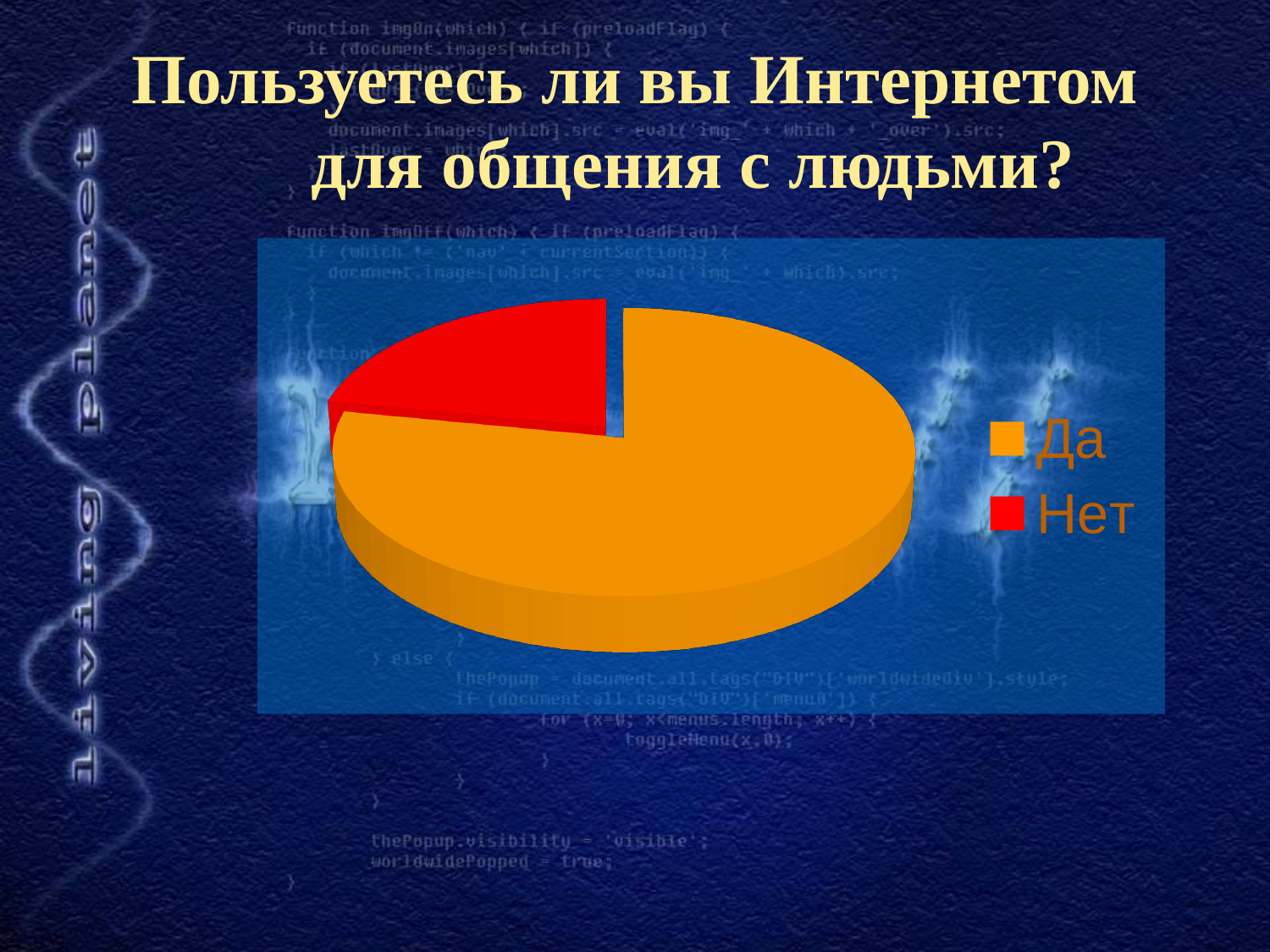
Which slice is larger, Да or Нет? Да Which category has the largest slice of the pie? Да Which category has the smallest slice of the pie? Нет What colour is the slice for Нет? red What is the title of the slide containing the pie chart? Пользуетесь ли вы Интернетом для общения с людьми? How many entries does the legend list? 2 How many slices does the pie chart have? 2 What kind of chart is shown on the slide? pie chart